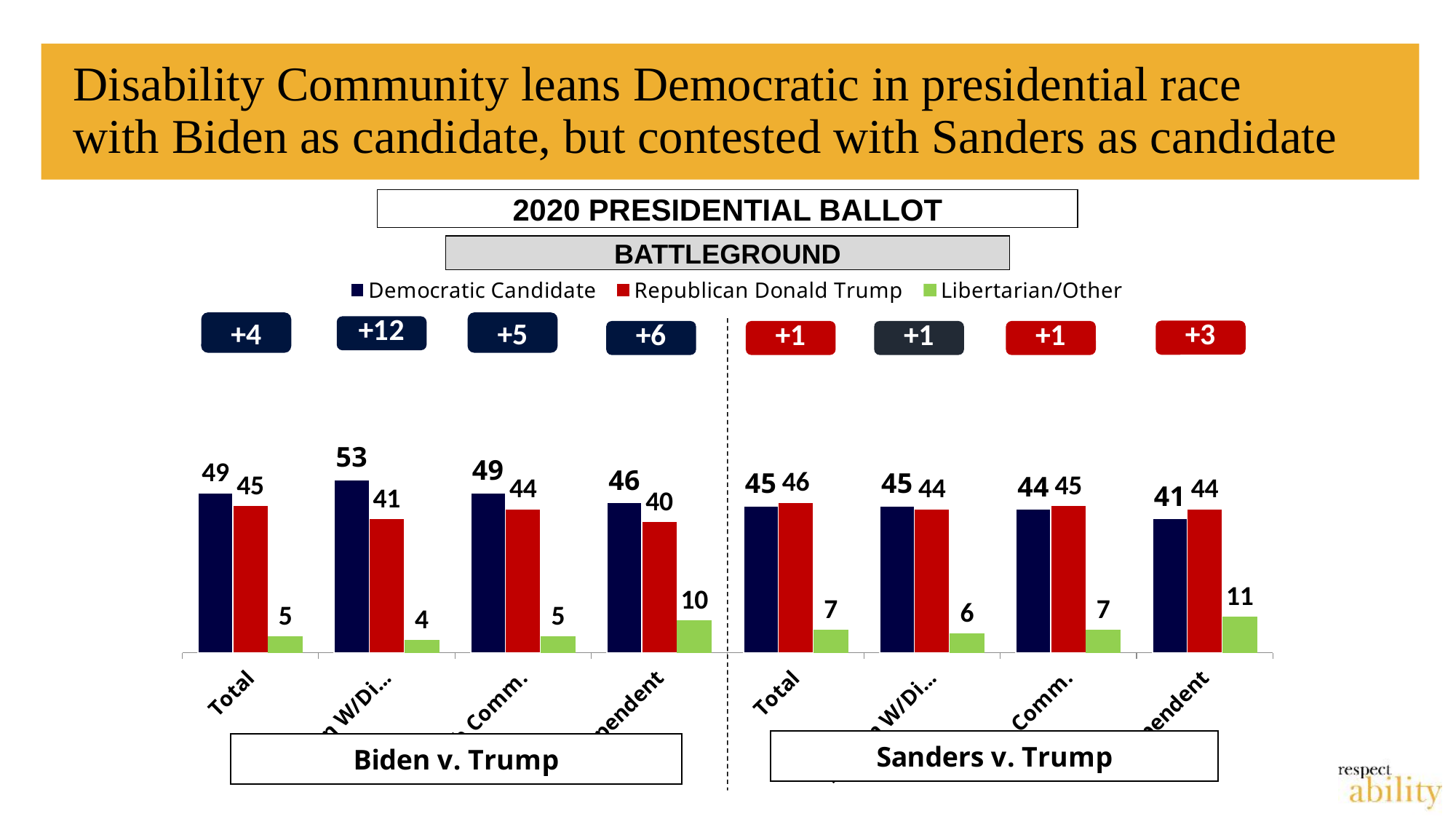
What kind of chart is shown on the slide? Bar chart How many category groups are shown in the Biden v. Trump section? 4 In the Biden v. Trump section, what is the difference between the Democratic Candidate and Republican Donald Trump values in the Total group? 4 In the Sanders v. Trump section's Total group, which is larger: the Democratic Candidate value or the Republican Donald Trump value? Republican Donald Trump What is the title shown in the box above the chart? 2020 PRESIDENTIAL BALLOT How many series does the chart legend list? 3 What is the highest Democratic Candidate value shown in the Biden v. Trump section? 53 In the Sanders v. Trump section, what is the value for Libertarian/Other in the Total group? 7 In the Sanders v. Trump section, what is the value for the Democratic Candidate in the Total group? 45 What is the highest Libertarian/Other value shown in the Sanders v. Trump section? 11 In the Biden v. Trump section, what is the value for the Democratic Candidate in the Total group? 49 In the Biden v. Trump section, what is the value for Republican Donald Trump in the Total group? 45